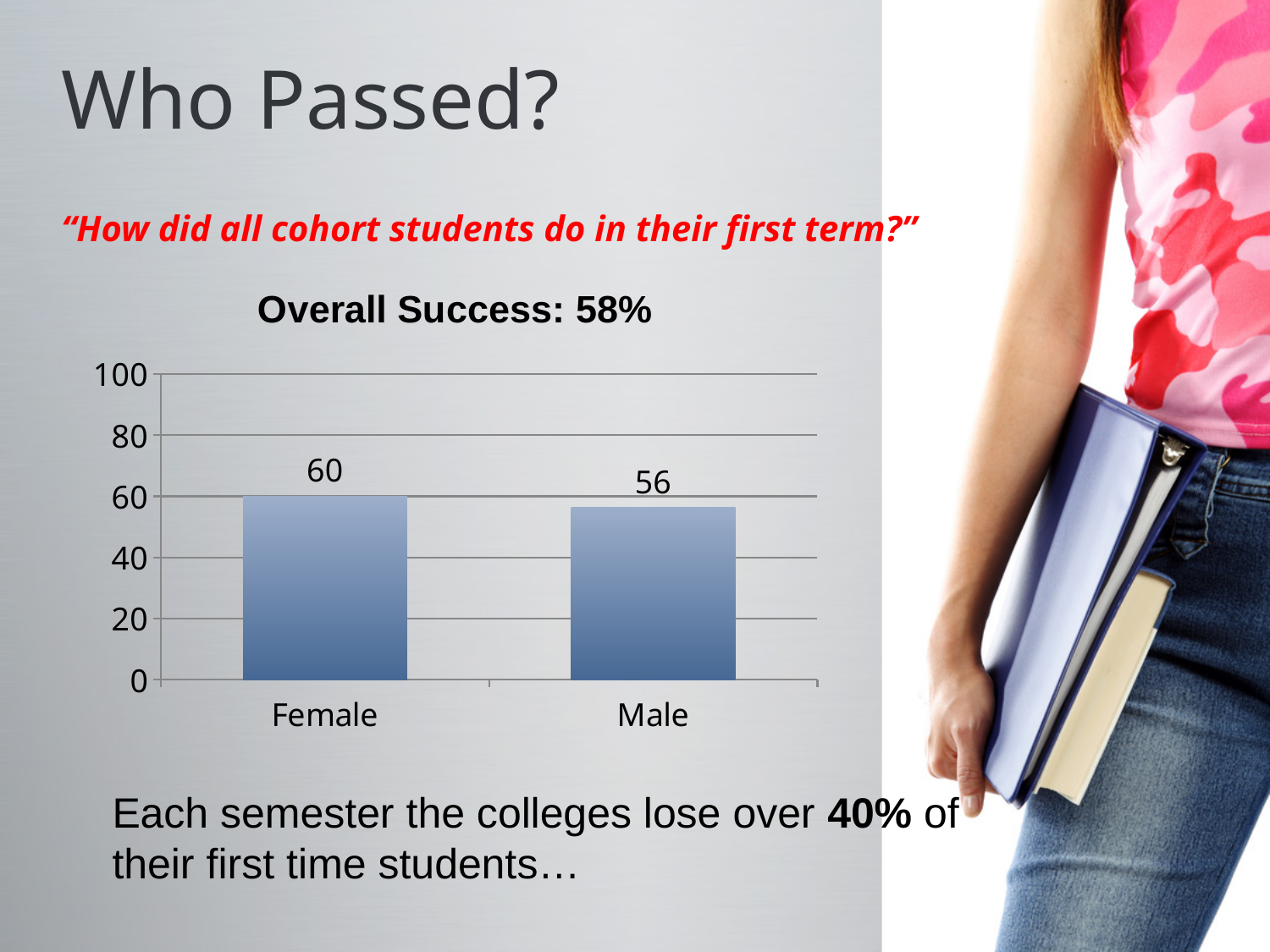
What is the value for Male? 56 Which is larger, the value for Female or the value for Male? Female What is the difference between the Female and Male values? 4 Which category has the highest value? Female Is the value for Female greater or less than 40? greater Which category has the lowest value? Male What is the value for Female? 60 Is the value for Male greater or less than 80? less What kind of chart is shown on the slide? bar chart How many categories are shown on the x axis? 2 What is the highest value shown on the y axis? 100 What is the title of the chart? Overall Success: 58%